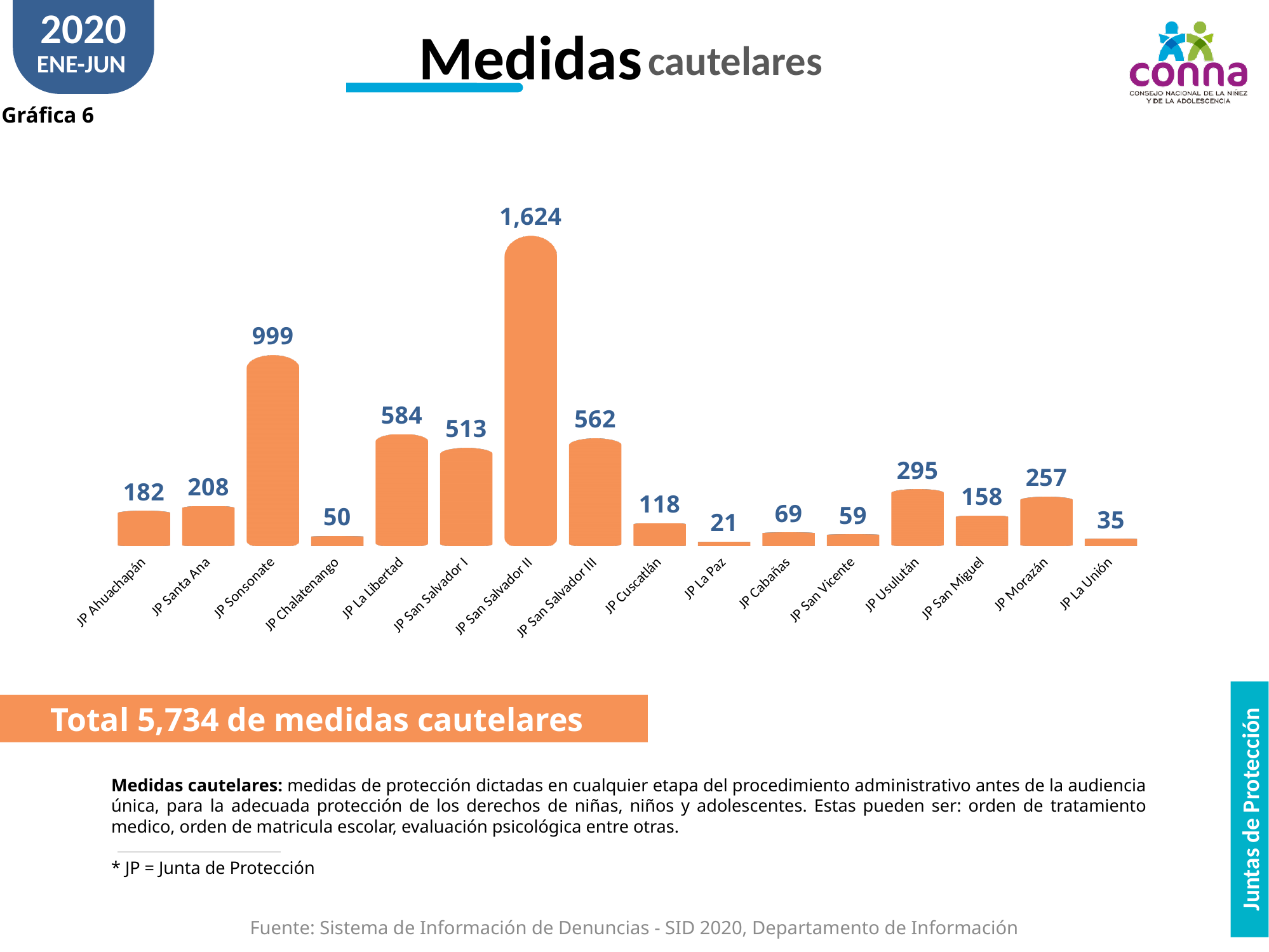
Which is larger, the value for JP La Libertad or JP San Salvador III? JP La Libertad Which category has the highest value? JP San Salvador II What kind of chart is shown on the slide? Bar chart What is the value for JP Sonsonate? 999 What is the value for JP Morazán? 257 How many categories are shown on the x axis? 16 What is the difference between the values for JP San Salvador II and JP Sonsonate? 625 What is the difference between the values for JP Santa Ana and JP Ahuachapán? 26 What total of medidas cautelares is stated on the slide? 5,734 What is the value for JP La Paz? 21 Which is larger, the value for JP Usulután or JP San Miguel? JP Usulután Which category has the lowest value? JP La Paz